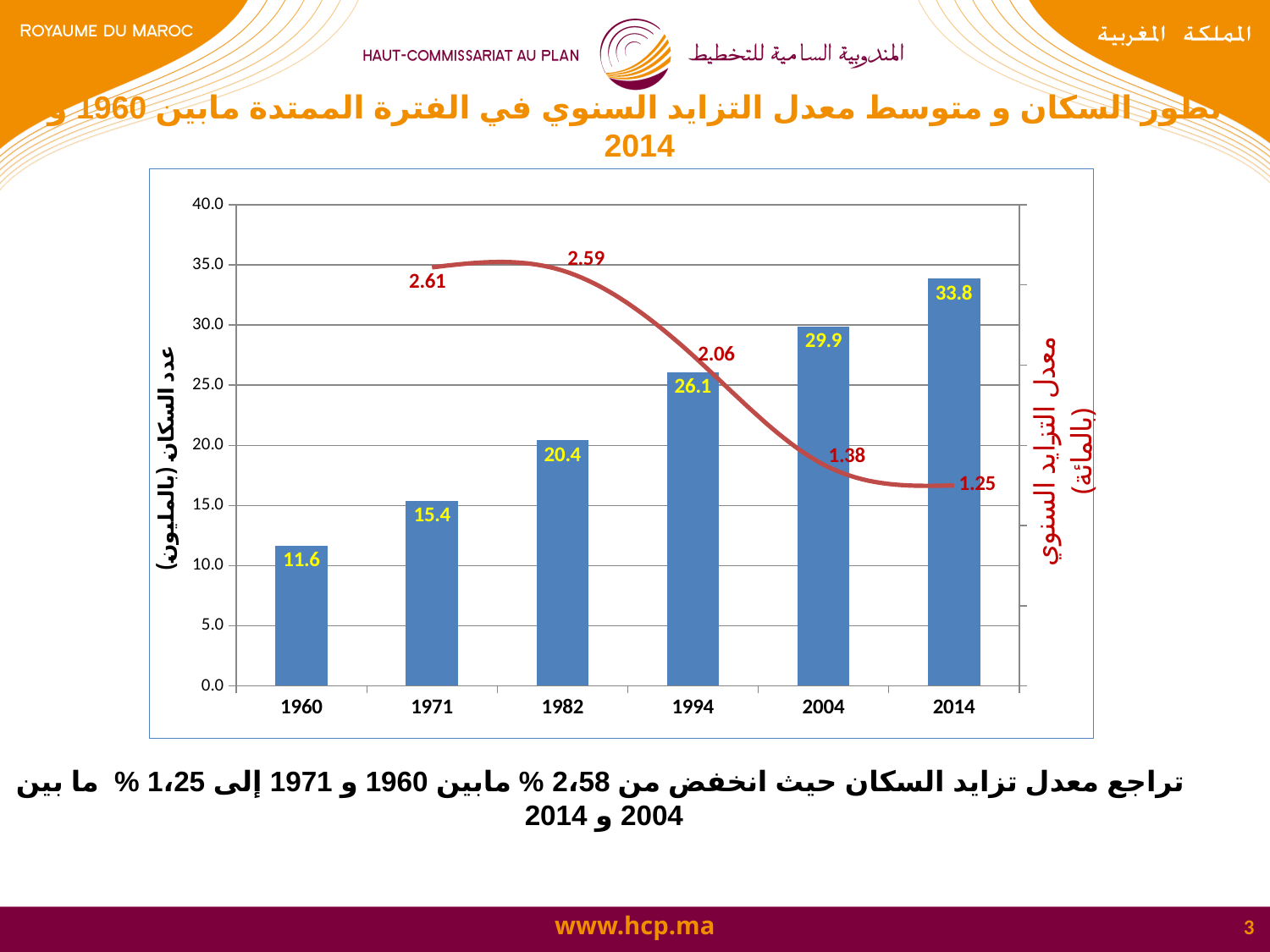
How many years are shown on the x axis? 6 Which year has the lowest population bar? 1960 What is the first (leftmost) value labelled on the red growth-rate line? 2.61 What is the difference between the population values for 2014 and 2004? 3.9 What is the population value (in millions) shown for 1960? 11.6 Which is larger, the population bar for 1982 or for 1971? 1982 Is the population bar for 2004 greater or less than 25.0? greater What is the population value (in millions) shown for 1994? 26.1 Do the population bars rise or fall from 1960 to 2014? rise What is the population value (in millions) shown for 2014? 33.8 Which year has the highest population bar? 2014 What is the last (rightmost) value labelled on the red growth-rate line? 1.25